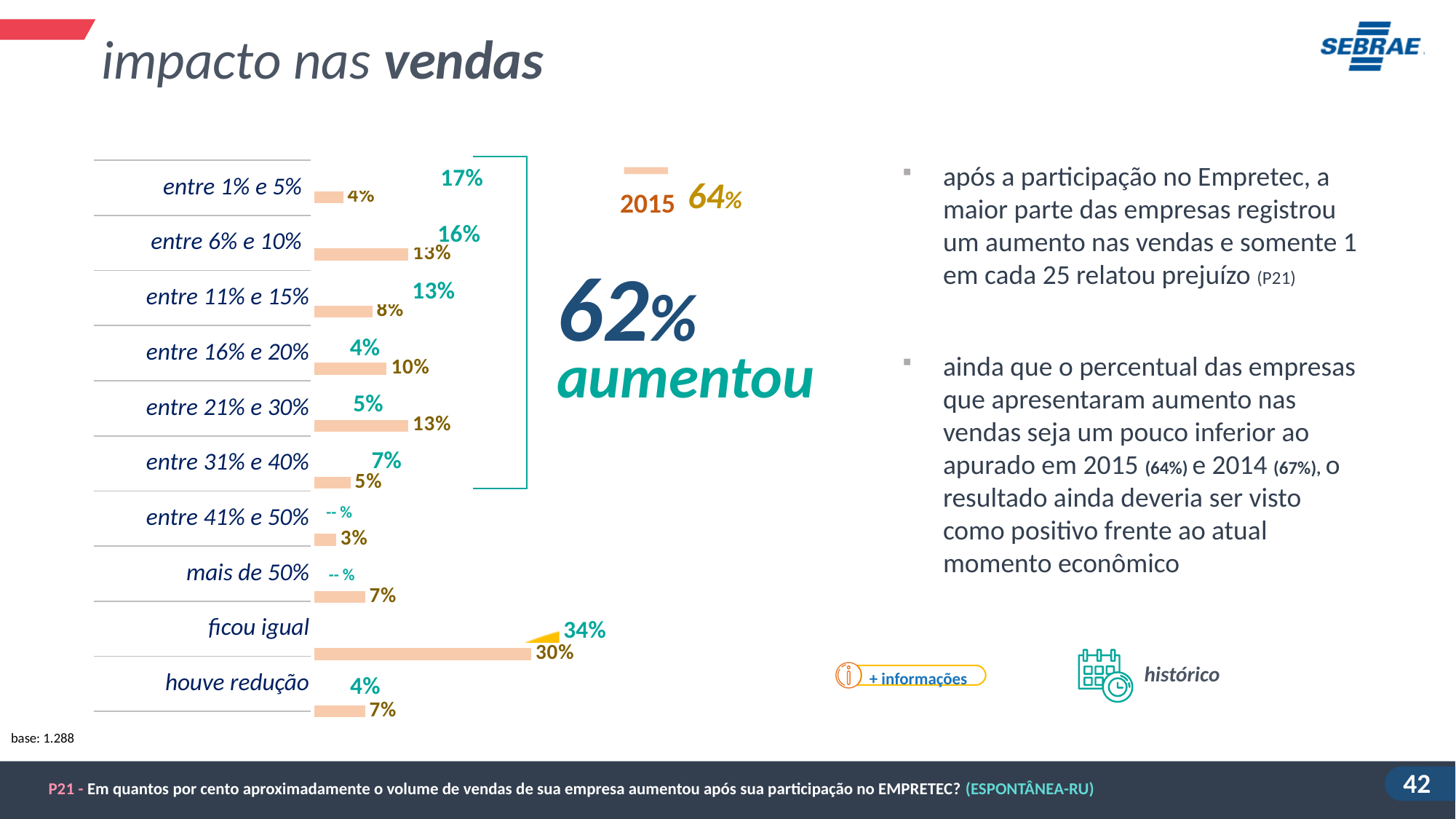
What is the difference between the bar values for 'ficou igual' and 'entre 6% e 10%'? 17 percentage points What is the bar value for 'houve redução'? 7% How many categories are listed in the bar chart? 10 What base (sample size) is stated below the chart? 1.288 What type of chart is shown on the slide? bar chart What is the bar value for 'ficou igual'? 30% What is the teal-labelled value shown for 'ficou igual'? 34% Which category has the shortest bar? entre 41% e 50% What is the bar value for 'entre 41% e 50%'? 3% Which has a larger bar value, 'entre 21% e 30%' or 'entre 11% e 15%'? entre 21% e 30% What is the bar value for 'entre 6% e 10%'? 13% Which category has the longest bar? ficou igual